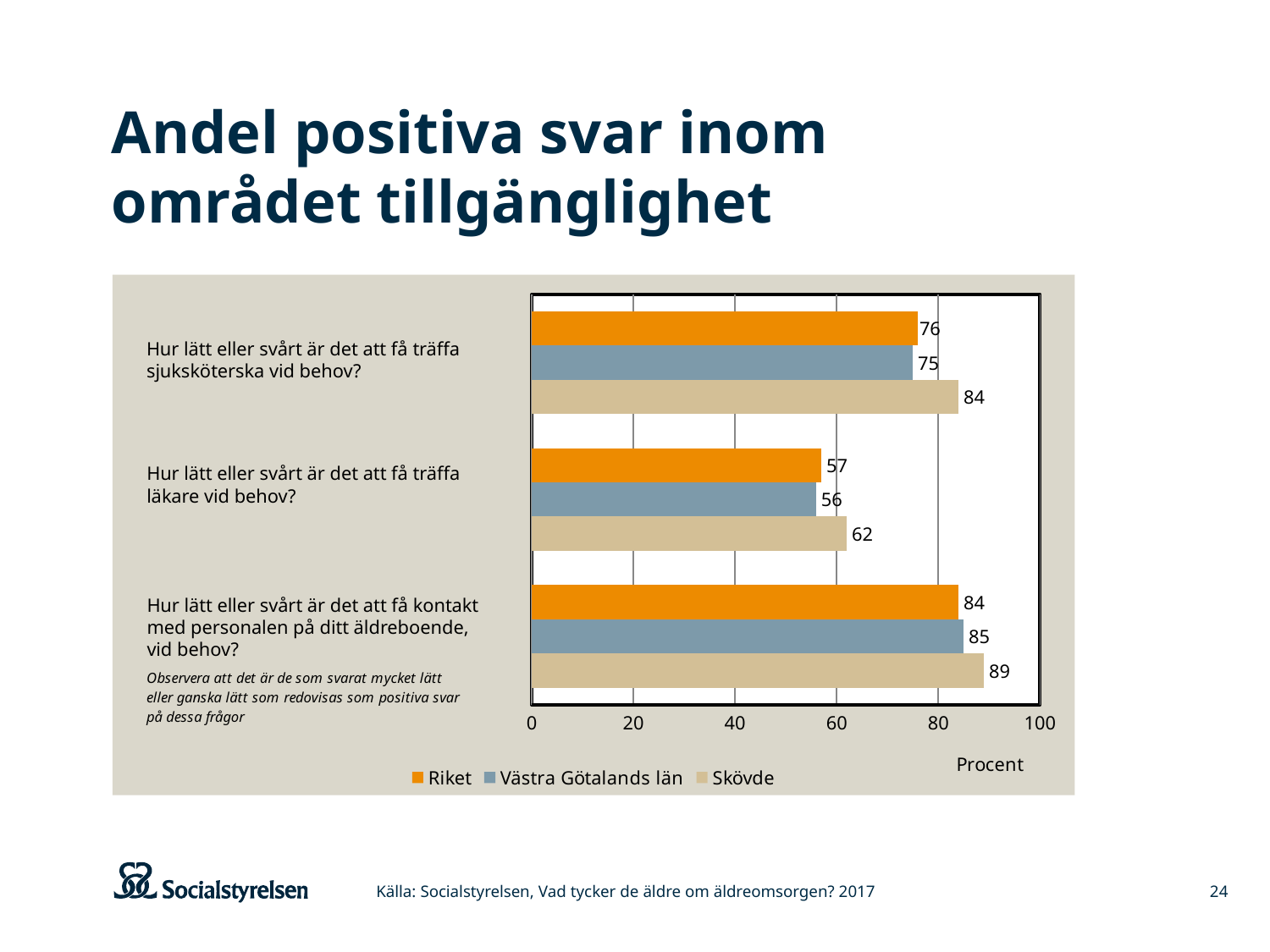
What is the value for Riket on the question "Hur lätt eller svårt är det att få träffa läkare vid behov?"? 57 What kind of chart is shown on the slide? Bar chart Is the value for Västra Götalands län on the question "Hur lätt eller svårt är det att få träffa läkare vid behov?" greater or less than 60? less Which is larger on the question "Hur lätt eller svårt är det att få kontakt med personalen på ditt äldreboende, vid behov?": Skövde or Riket? Skövde What is the difference between the Skövde value and the Riket value on the question "Hur lätt eller svårt är det att få träffa sjuksköterska vid behov?"? 8 How many questions (categories) are shown on the chart? 3 What is the value for Skövde on the question "Hur lätt eller svårt är det att få träffa sjuksköterska vid behov?"? 84 How many series does the legend list? 3 What is the value for Västra Götalands län on the question "Hur lätt eller svårt är det att få kontakt med personalen på ditt äldreboende, vid behov?"? 85 Which question has the lowest value for Skövde? Hur lätt eller svårt är det att få träffa läkare vid behov? Which series has the highest value on the question "Hur lätt eller svårt är det att få träffa läkare vid behov?"? Skövde What is the label of the horizontal axis? Procent